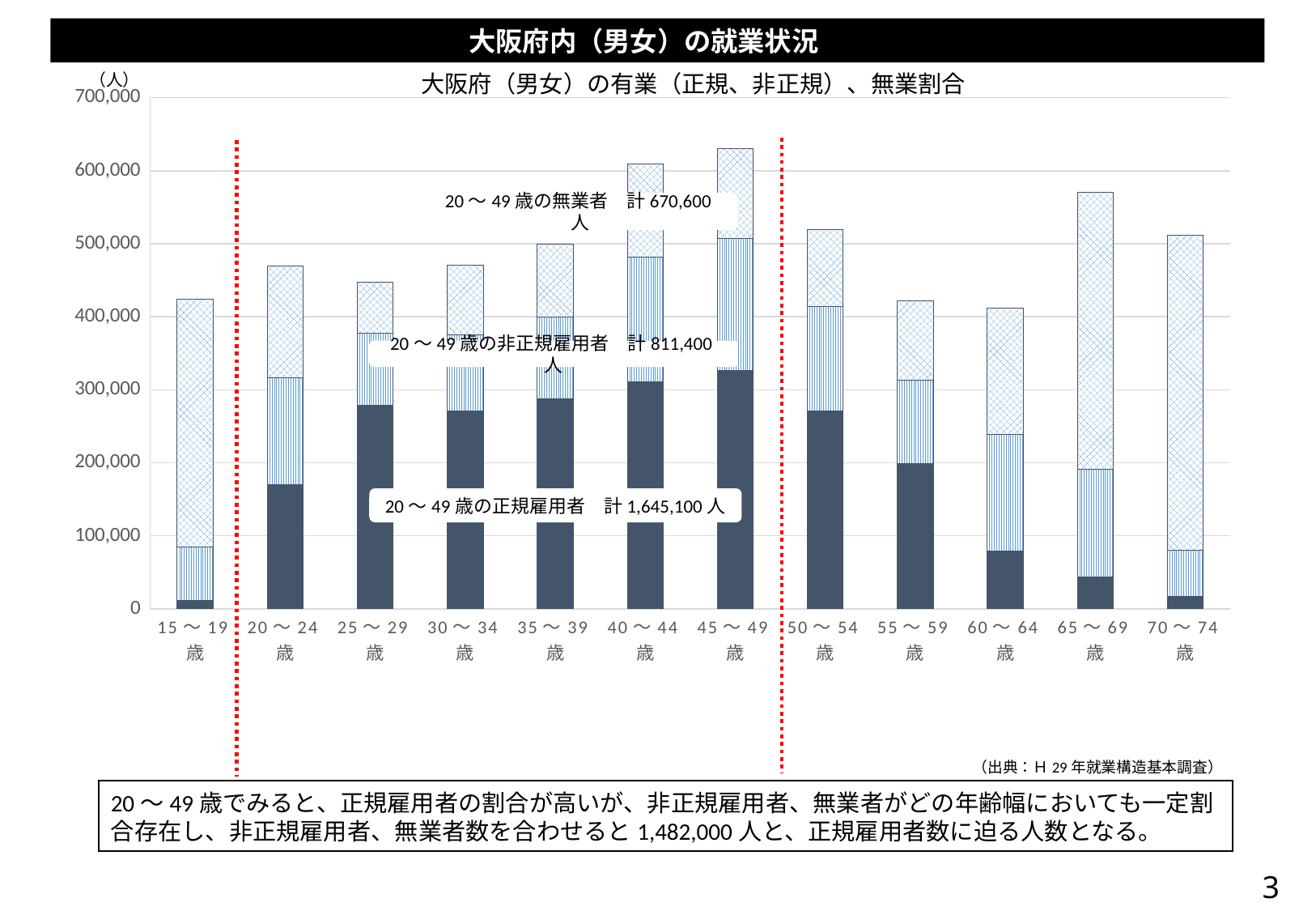
According to the annotation on the chart, what is the total number of 正規雇用者 aged 20～49歳? 1,645,100人 Which has the larger dark (bottom) segment, 45～49歳 or 20～24歳? 45～49歳 Is the total height of the bar for 15～19歳 greater or less than 500,000? less What kind of chart is shown on the slide? stacked bar chart Is the total height of the bar for 65～69歳 greater or less than 500,000? greater Which age group has the tallest stacked bar overall? 45～49歳 Is the dark (bottom) segment of the bar for 45～49歳 greater or less than 300,000? greater According to the annotation on the chart, what is the total number of 無業者 aged 20～49歳? 670,600人 How many age categories are shown on the x axis of the chart? 12 According to the annotation on the chart, what is the total number of 非正規雇用者 aged 20～49歳? 811,400人 What is the title of the chart? 大阪府（男女）の有業（正規、非正規）、無業割合